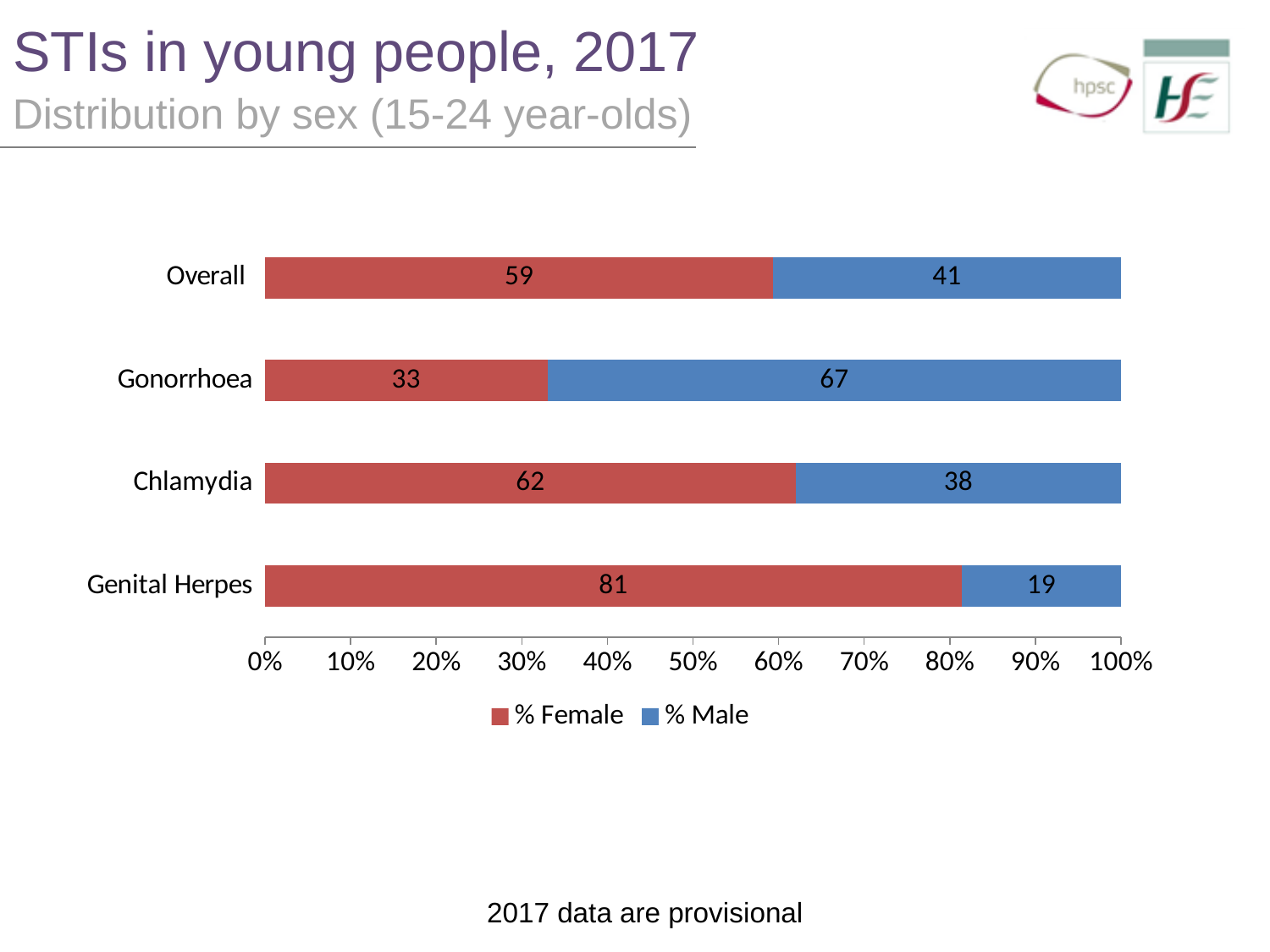
How many categories are shown on the chart? 4 How many series does the legend list? 2 What is the total of the stacked bar for Chlamydia? 100 What is the % Male value for Gonorrhoea? 67 Which category has the lowest % Male value? Genital Herpes What is the % Male value for Chlamydia? 38 What is the % Female value for Overall? 59 Which is larger, the % Male value for Gonorrhoea or the % Male value for Overall? Gonorrhoea What kind of chart is shown on the slide? Stacked bar chart What is the difference between the % Female values for Chlamydia and Gonorrhoea? 29 Which category has the highest % Female value? Genital Herpes What is the % Female value for Genital Herpes? 81